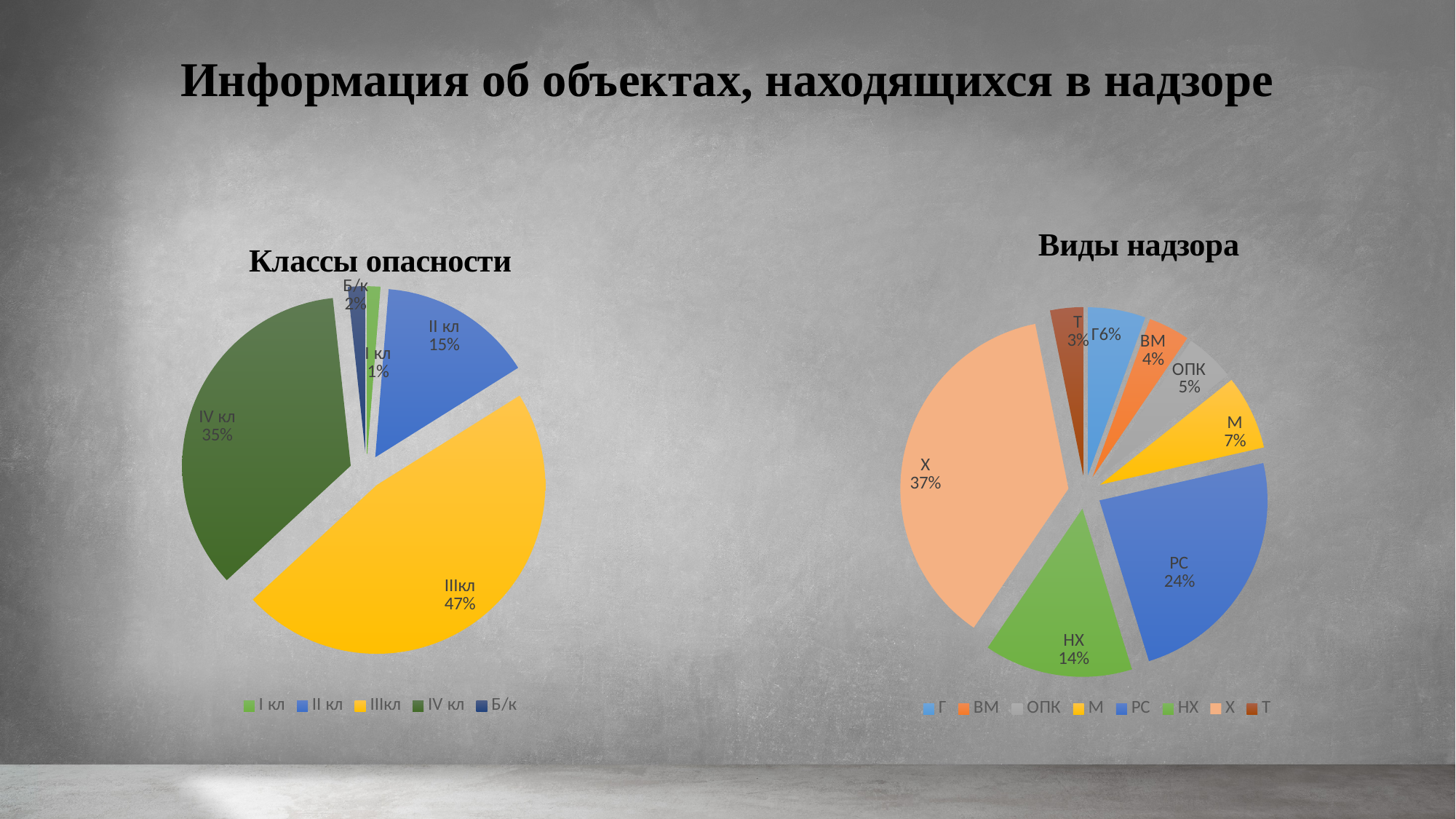
In the chart titled "Классы опасности", how many categories does the legend list? 5 In the chart titled "Классы опасности", what share does IV кл have? 35% In the chart titled "Виды надзора", how many categories does the legend list? 8 In the chart titled "Виды надзора", which category has the largest share? Х In the chart titled "Виды надзора", what share does ОПК have? 5% In the chart titled "Классы опасности", which category has the largest share? IIIкл What type of chart is the chart titled "Виды надзора"? Pie chart In the chart titled "Классы опасности", which category has the smallest share? I кл In the chart titled "Классы опасности", what is the difference between the shares of IIIкл and IV кл? 12% In the chart titled "Классы опасности", what share does IIIкл have? 47% In the chart titled "Виды надзора", which is larger, НХ or М? НХ In the chart titled "Виды надзора", what share does РС have? 24%